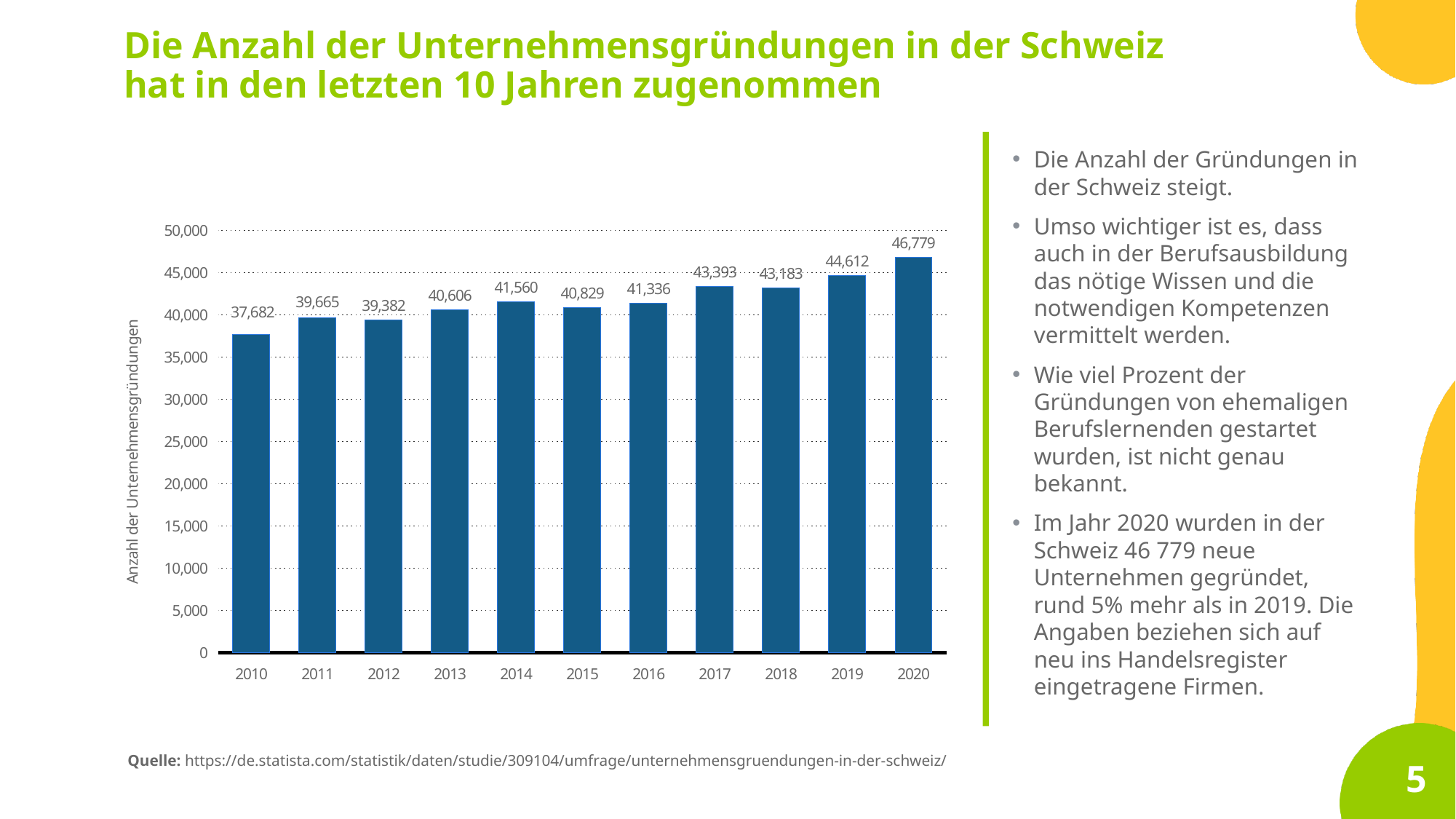
How many years are shown on the x axis? 11 What is the difference between the values for 2014 and 2013? 954 Which year has the highest number of company foundations? 2020 What is the value shown for 2016? 41,336 Which year has a larger value, 2017 or 2018? 2017 What is the number of company foundations in Switzerland in 2010? 37,682 Which year has the lowest number of company foundations? 2010 What kind of chart is shown on the slide? bar chart What is the label of the vertical axis? Anzahl der Unternehmensgründungen What is the value shown for 2019? 44,612 Is the value for 2012 greater or less than 40,000? less What is the difference between the values for 2020 and 2019? 2,167